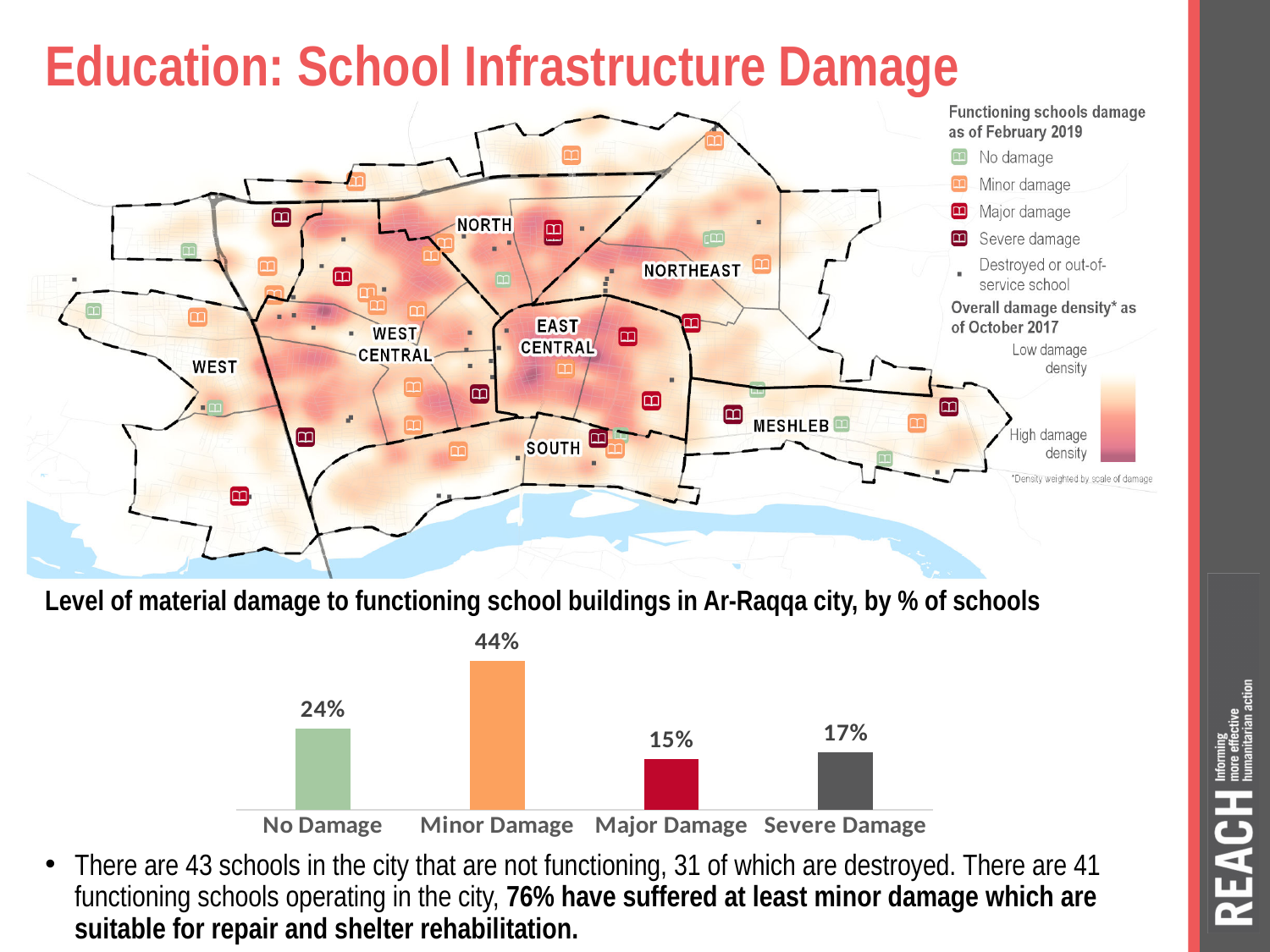
What percentage of functioning schools have major damage? 15% What type of chart is used to show the level of material damage to school buildings? Bar chart What percentage of functioning schools have no damage? 24% Which damage category has the lowest percentage of schools? Major Damage Which is larger, the percentage for No Damage or for Severe Damage? No Damage What percentage of functioning schools have severe damage? 17% How many damage categories are shown in the bar chart? 4 What is the title of the bar chart? Level of material damage to functioning school buildings in Ar-Raqqa city, by % of schools Which damage category has the highest percentage of schools? Minor Damage What percentage of functioning schools have minor damage? 44% What is the difference in percentage points between Minor Damage and No Damage? 20 What is the difference in percentage points between Severe Damage and Major Damage? 2